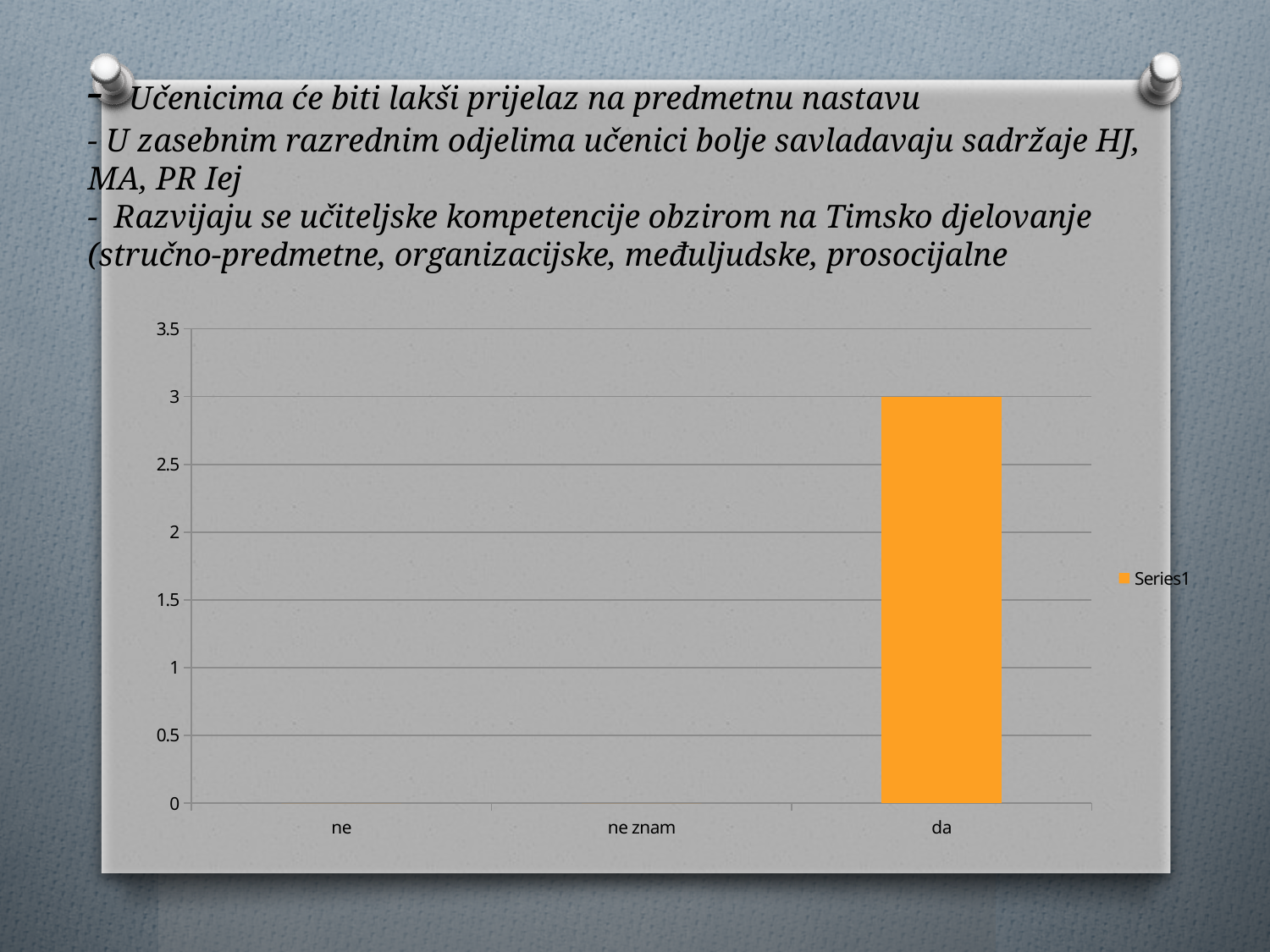
How many series does the chart legend list? 1 How many categories are shown on the x axis of the chart? 3 What is the highest value shown on the y axis? 3.5 What is the name of the series shown in the legend? Series1 Which is larger, the value for "da" or the value for "ne"? da What colour is the bar for "da"? orange Which category has the highest value? da Is the value for "da" greater or less than 2.5? greater What is the value for the category "da"? 3 What kind of chart is shown on the slide? bar chart Which is larger, the value for "da" or the value for "ne znam"? da Is the value for "da" greater or less than 3.5? less